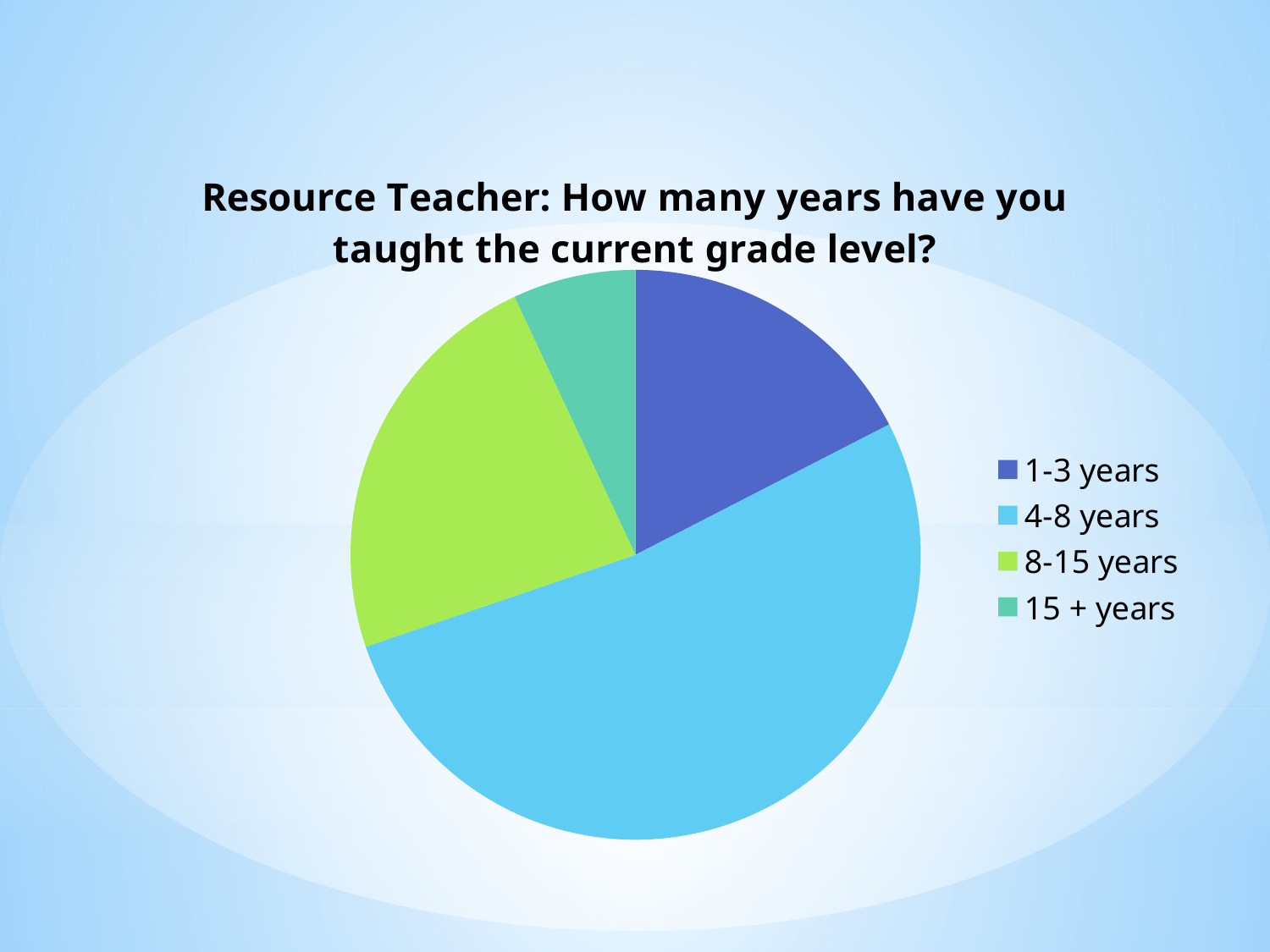
Does the 4-8 years slice make up more or less than half of the pie? more What kind of chart is shown on the slide? pie chart What is the title of the chart? Resource Teacher: How many years have you taught the current grade level? Which slice is larger, 1-3 years or 15 + years? 1-3 years How many entries does the legend list? 4 How many slices does the pie chart have? 4 Which slice is larger, 4-8 years or 8-15 years? 4-8 years Which category has the smallest slice of the pie? 15 + years Which category is shown in green in the pie chart? 8-15 years Which slice is larger, 8-15 years or 1-3 years? 8-15 years Which category has the largest slice of the pie? 4-8 years